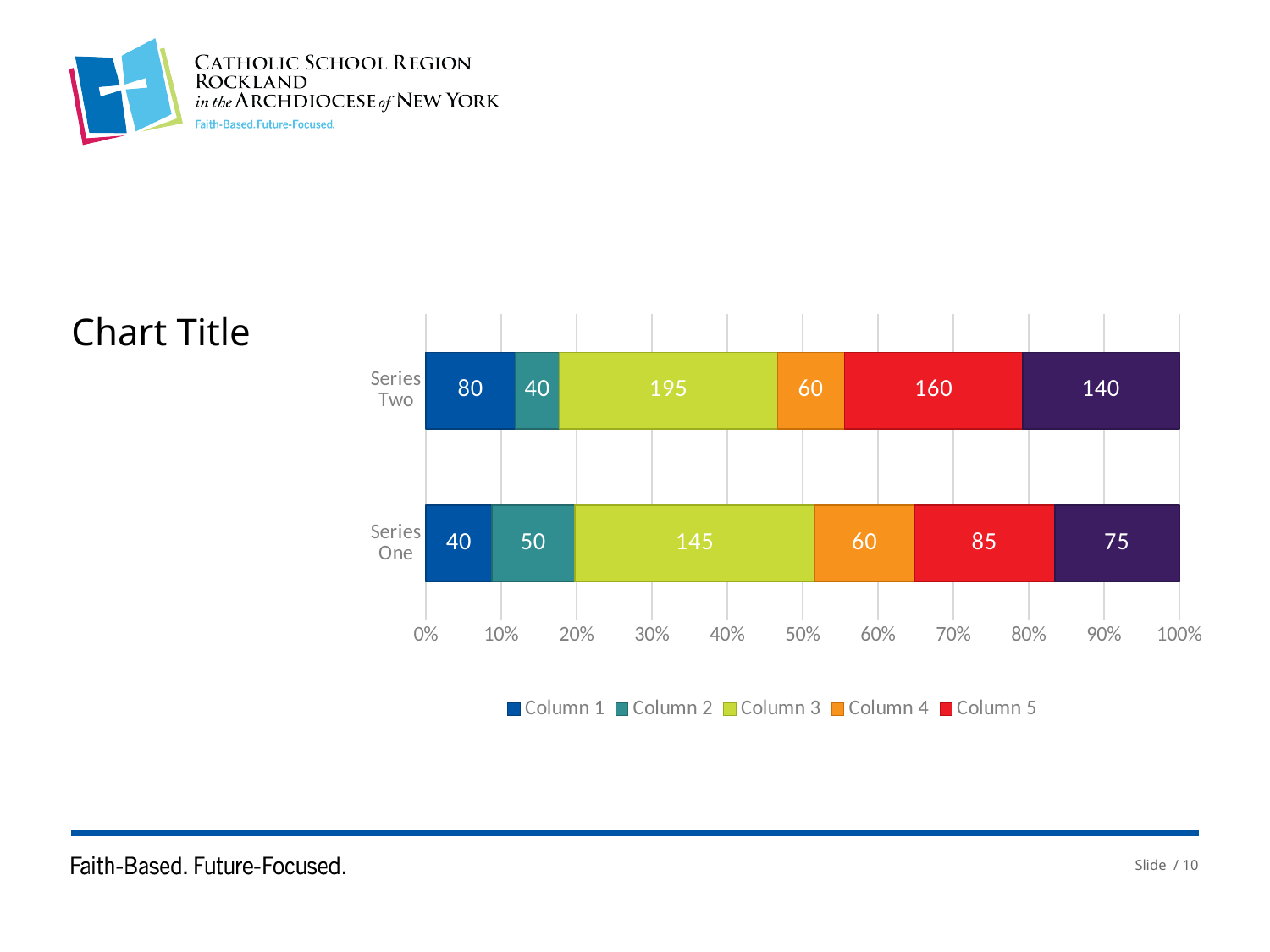
Which is larger, Column 1 for Series Two or Column 1 for Series One? Series Two What is the title of the chart? Chart Title How many series does the legend list? 5 What is the difference between the Column 5 values for Series Two and Series One? 75 What is the value of Column 3 for Series Two? 195 What is the value of Column 1 for Series One? 40 What is the value of Column 2 for Series One? 50 How many categories (bars) are shown on the chart? 2 What kind of chart is shown on the slide? bar chart What is the value of Column 5 for Series Two? 160 Which segment has the largest value in the Series One bar? Column 3 What is the total of all segments in the Series Two bar? 675